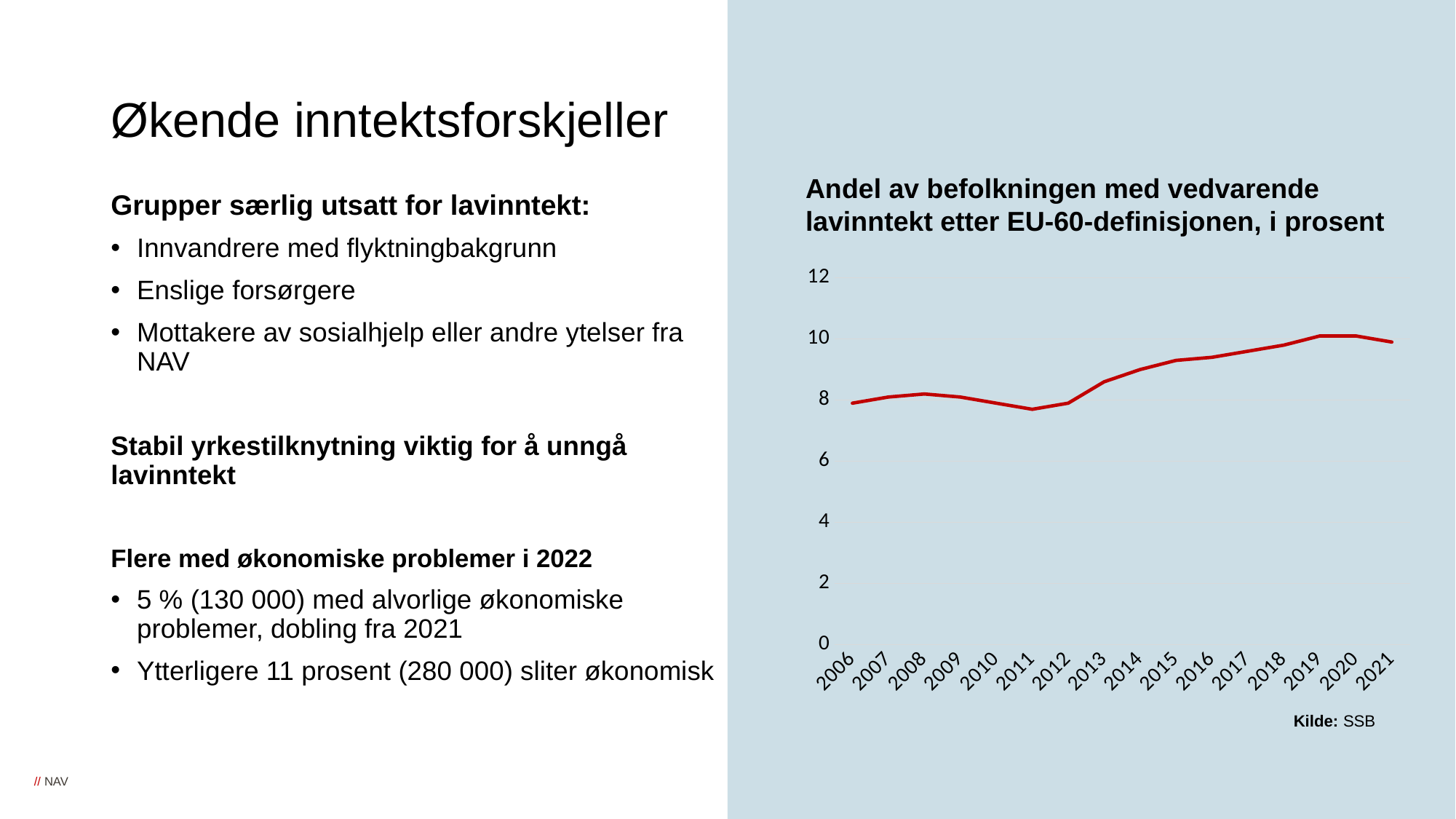
Is the value for 2013 greater or less than 10? less Does the share of the population with persistent low income generally rise or fall from 2006 to 2021? rise Is the value for 2011 greater or less than 8? less Is the value for 2006 greater or less than 10? less How many years are shown on the x axis of the chart? 16 What is the title of the chart? Andel av befolkningen med vedvarende lavinntekt etter EU-60-definisjonen, i prosent What source is cited for the chart? SSB What kind of chart is shown on the slide? line chart Which year has the larger value, 2008 or 2016? 2016 Which year has the larger value, 2011 or 2019? 2019